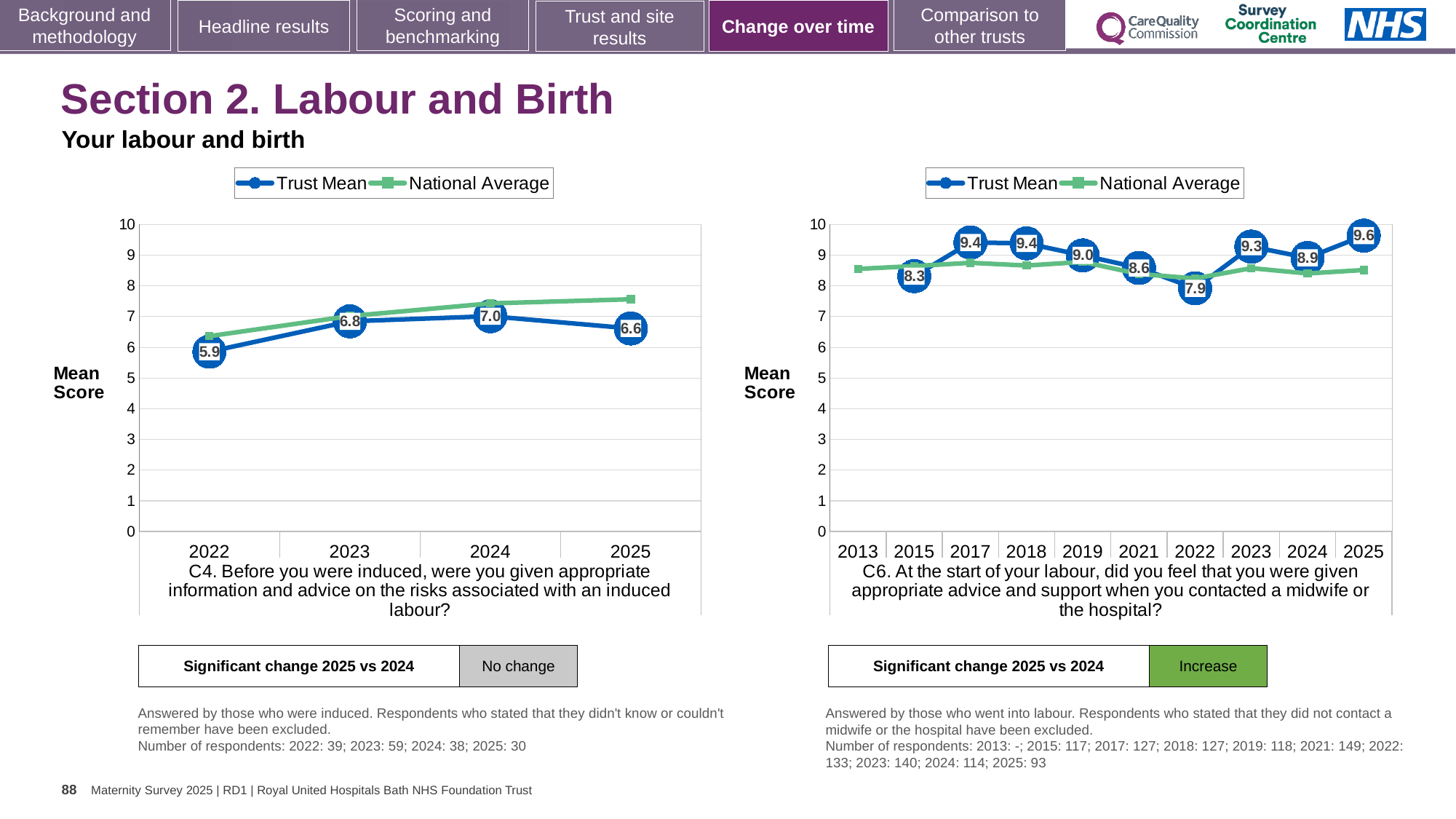
In the right chart (C6), which year has the lowest labelled Trust Mean? 2022 In the left chart (C4), is the National Average for 2025 greater or less than 7? greater In the left chart (C4), what is the difference between the Trust Mean in 2024 and in 2022? 1.1 In the left chart (C4), which year has the highest Trust Mean? 2024 In the left chart (C4), how many series does the legend list? 2 In the left chart (C4), what is the Trust Mean for 2022? 5.9 In the right chart (C6), what is the Trust Mean for 2022? 7.9 In the right chart (C6), is the Trust Mean larger in 2023 or in 2024? 2023 What kind of chart is the right chart (C6)? Line chart In the right chart (C6), which year has the highest Trust Mean? 2025 In the right chart (C6), how many years are shown on the x axis? 10 In the left chart (C4), what is the Trust Mean for 2025? 6.6